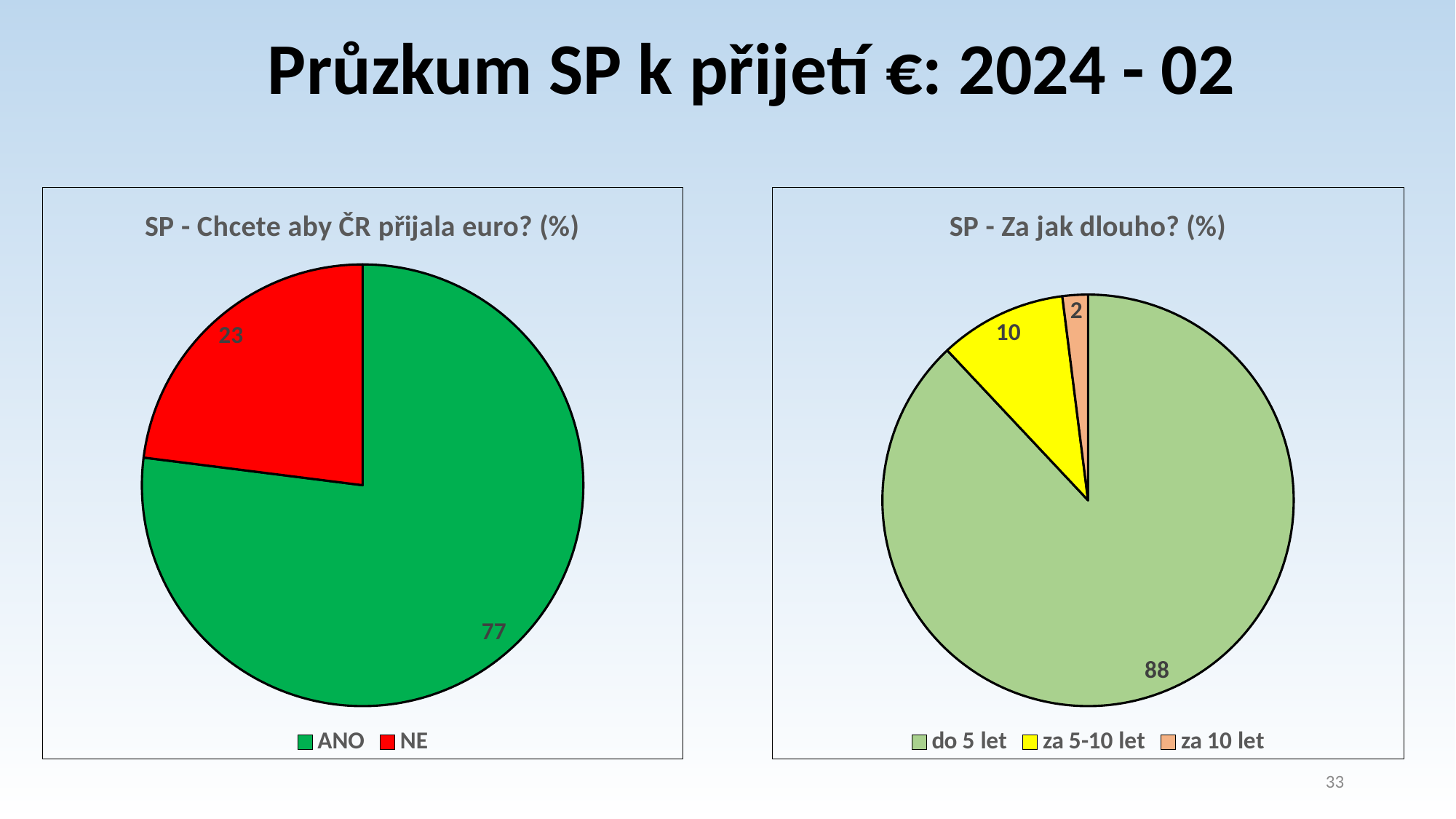
What kind of chart is the left chart, "SP - Chcete aby ČR přijala euro? (%)"? pie chart In the chart titled "SP - Za jak dlouho? (%)", which category has the largest slice? do 5 let In the chart titled "SP - Chcete aby ČR přijala euro? (%)", what is the difference between the ANO and NE values? 54 How many categories does the legend of the chart titled "SP - Za jak dlouho? (%)" list? 3 In the chart titled "SP - Za jak dlouho? (%)", which category has the smallest slice? za 10 let In the chart titled "SP - Chcete aby ČR přijala euro? (%)", what is the value for ANO? 77 In the chart titled "SP - Chcete aby ČR přijala euro? (%)", what is the value for NE? 23 In the chart titled "SP - Za jak dlouho? (%)", what is the value for "za 10 let"? 2 In the chart titled "SP - Chcete aby ČR přijala euro? (%)", which slice is larger, ANO or NE? ANO In the chart titled "SP - Za jak dlouho? (%)", what is the value for "do 5 let"? 88 In the chart titled "SP - Za jak dlouho? (%)", what is the value for "za 5-10 let"? 10 In the chart titled "SP - Za jak dlouho? (%)", what is the difference between the "za 5-10 let" and "za 10 let" values? 8